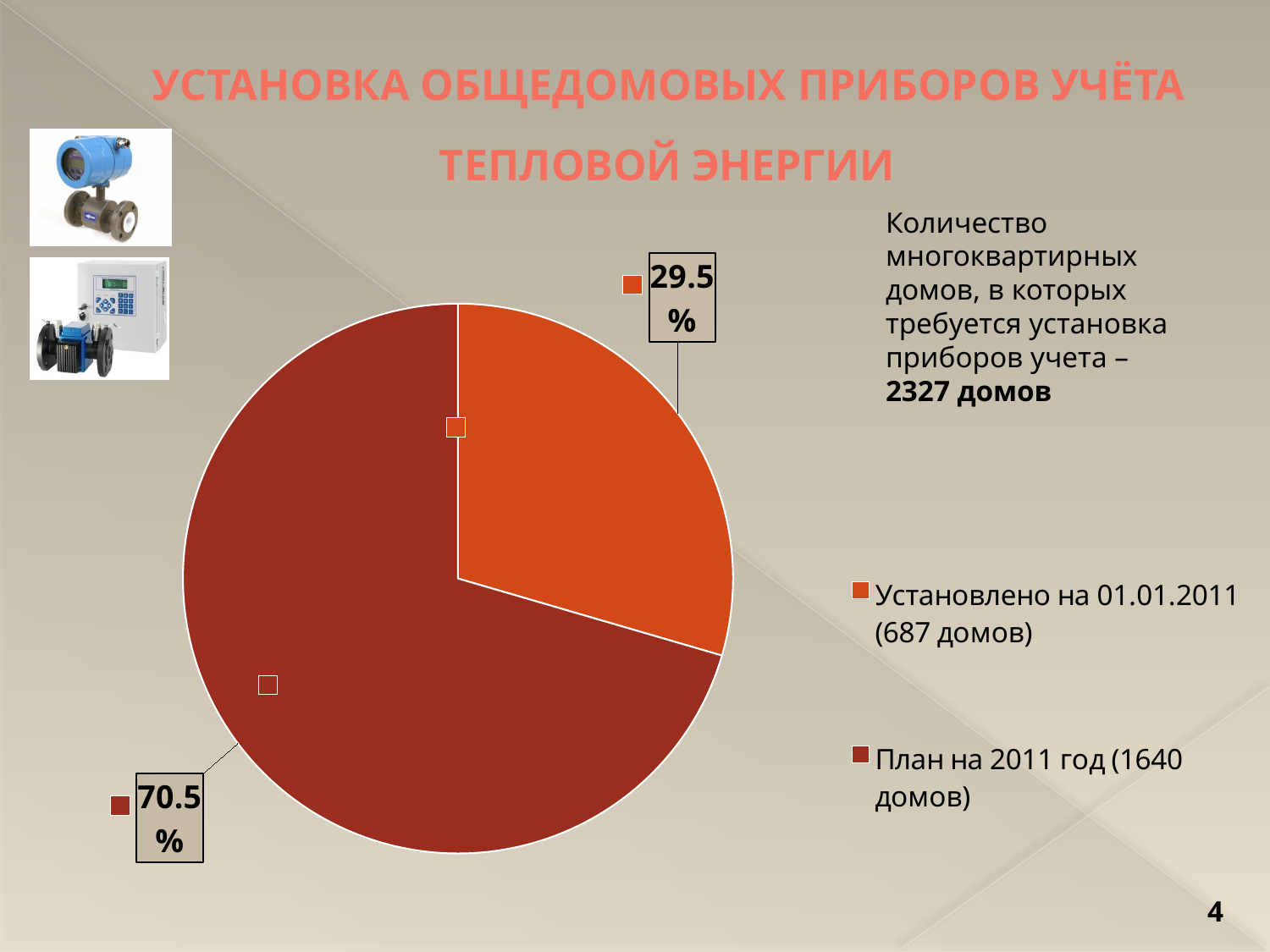
Which slice of the pie chart is the smallest? Установлено на 01.01.2011 (687 домов) What colour is the slice labelled 70.5%? dark red What kind of chart is shown on the slide? pie chart Is the share for "Установлено на 01.01.2011" greater or less than 50%? less How many slices does the pie chart have? 2 What share of the pie does the slice "Установлено на 01.01.2011 (687 домов)" represent? 29.5% How many entries does the legend of the pie chart list? 2 What is the difference in percentage points between the "План на 2011 год" slice and the "Установлено на 01.01.2011" slice? 41 percentage points What share of the pie does the slice "План на 2011 год (1640 домов)" represent? 70.5% Which slice of the pie chart is the largest? План на 2011 год (1640 домов) Which is larger: the share for "Установлено на 01.01.2011" or the share for "План на 2011 год"? План на 2011 год What is the title of the slide containing the pie chart? УСТАНОВКА ОБЩЕДОМОВЫХ ПРИБОРОВ УЧЁТА ТЕПЛОВОЙ ЭНЕРГИИ